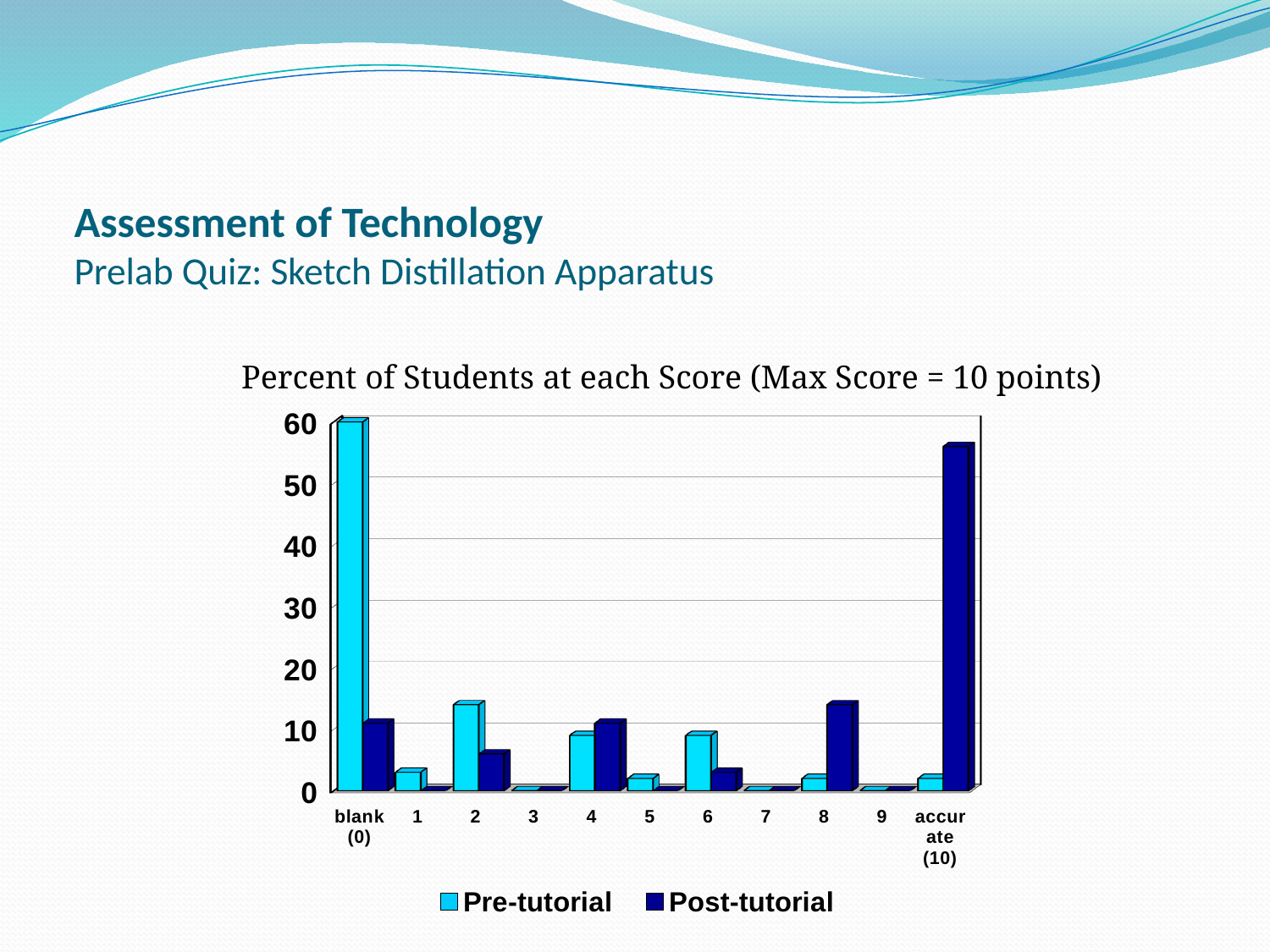
How many series does the legend list? 2 What kind of chart is shown on the slide? bar chart Is the Post-tutorial value for blank (0) greater or less than 20? less For blank (0), which series has the larger value, Pre-tutorial or Post-tutorial? Pre-tutorial For accurate (10), which series has the larger value, Pre-tutorial or Post-tutorial? Post-tutorial Which score category has the highest Pre-tutorial value? blank (0) Which score category has the highest Post-tutorial value? accurate (10) What is the title of the chart? Percent of Students at each Score (Max Score = 10 points) How many score categories are shown on the x axis? 11 Is the Pre-tutorial value for score 2 greater or less than 10? greater Is the Post-tutorial value for accurate (10) greater or less than 50? greater